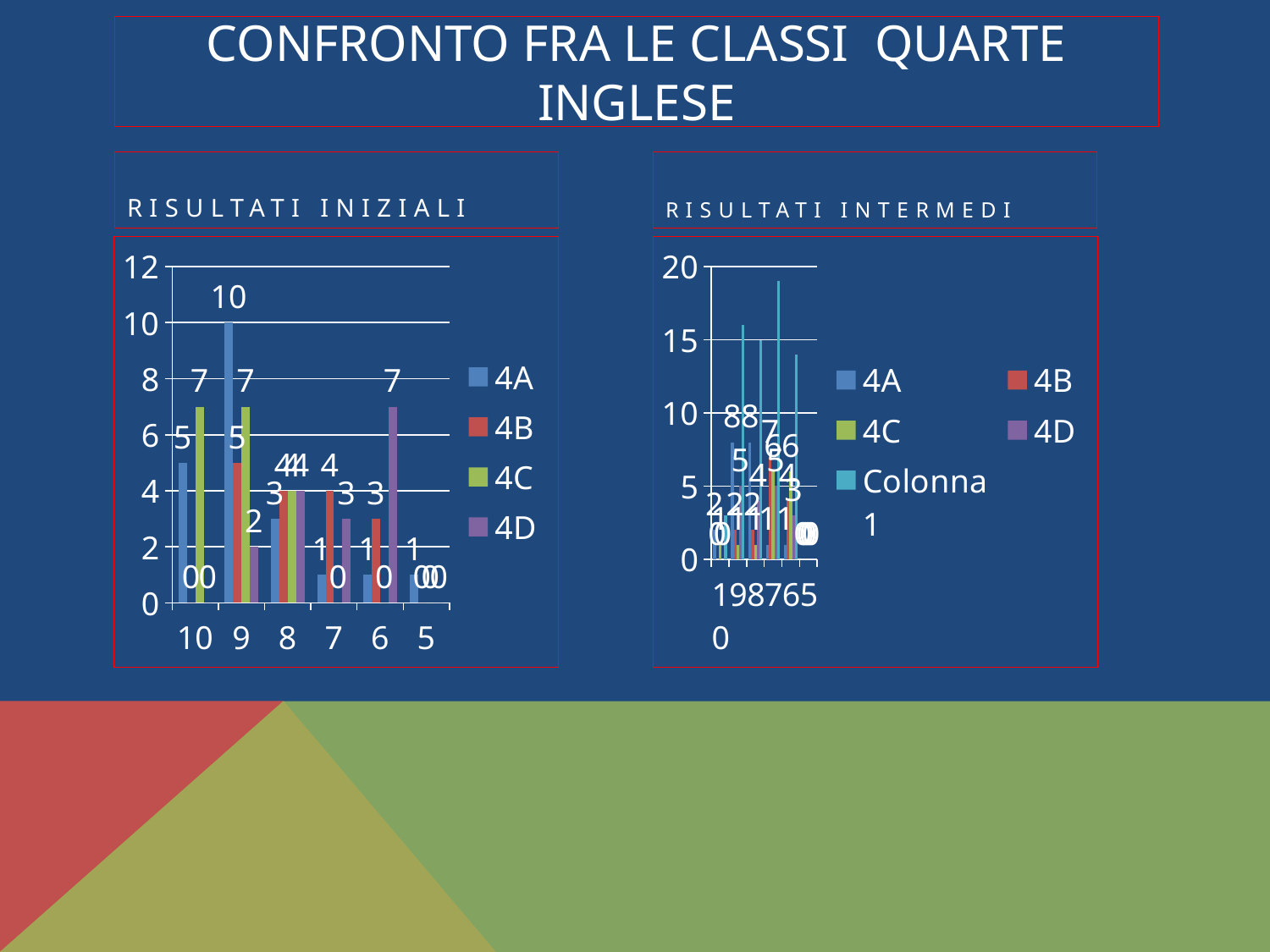
What kind of chart is the RISULTATI INTERMEDI chart? bar chart In the RISULTATI INIZIALI chart, what is the value for 4A at category 9? 10 In the RISULTATI INIZIALI chart, what is the value for 4C at category 10? 7 In the RISULTATI INIZIALI chart, what is the value for 4B at category 6? 3 How many categories are shown on the x axis of the RISULTATI INIZIALI chart? 6 In the RISULTATI INIZIALI chart, what is the value for 4D at category 6? 7 In the RISULTATI INIZIALI chart, which category has the highest value for 4A? 9 In the RISULTATI INIZIALI chart, what is the value for 4D at category 9? 2 How many series does the legend of the RISULTATI INTERMEDI chart list? 5 In the RISULTATI INIZIALI chart, what is the difference between 4A and 4B at category 9? 5 How many series does the legend of the RISULTATI INIZIALI chart list? 4 In the RISULTATI INIZIALI chart, at category 9, which is larger: 4C or 4D? 4C